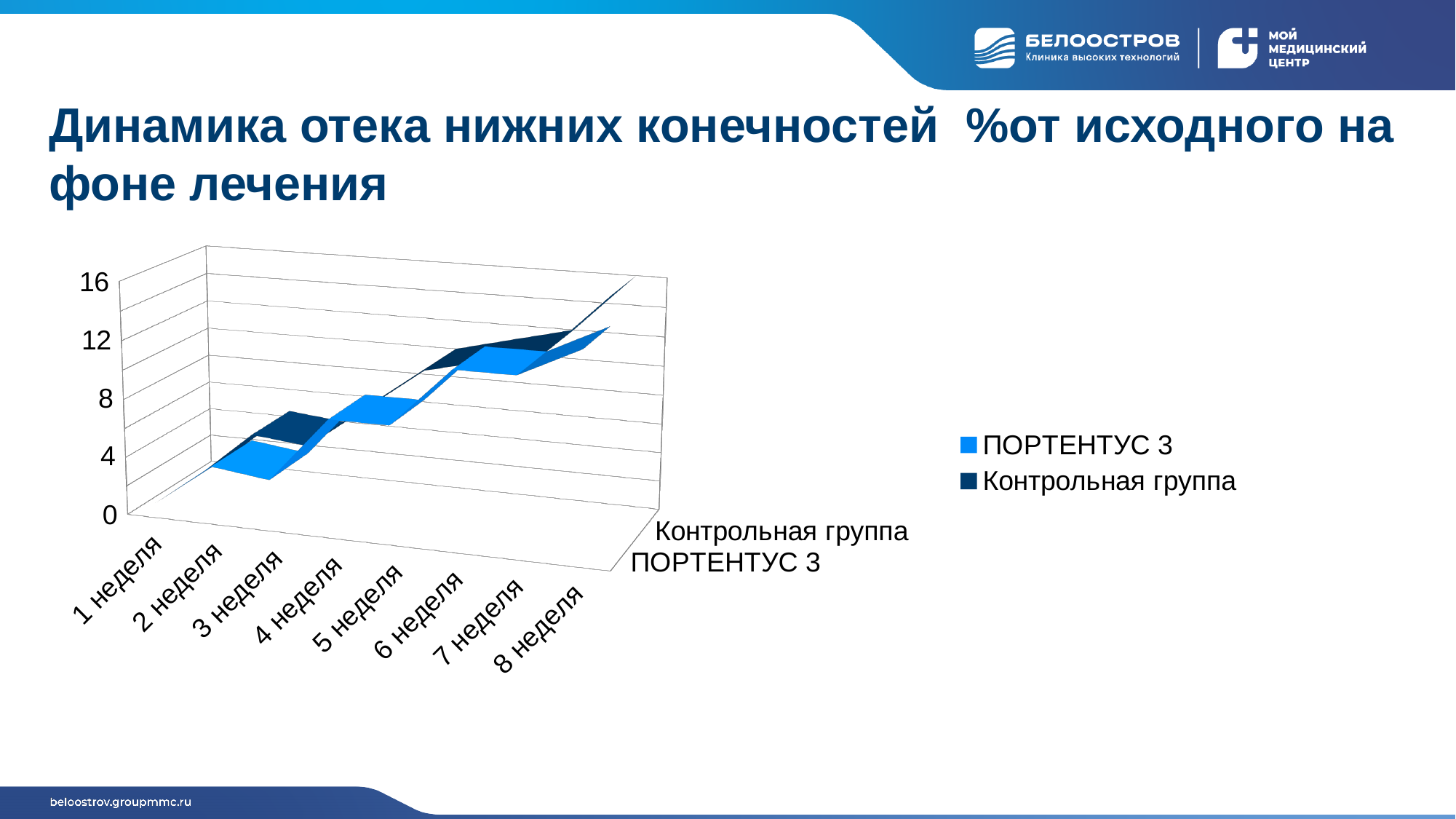
Is the value for ПОРТЕНТУС 3 at 8 неделя greater or less than 4? greater Is the value for ПОРТЕНТУС 3 at 1 неделя greater or less than 8? less Is the value for Контрольная группа at 8 неделя greater or less than 8? greater How many series does the legend list? 2 What kind of chart is shown on the slide? 3D line chart Do the values rise or fall from 1 неделя to 8 неделя? rise What is the highest tick value shown on the vertical axis? 16 Which two series are listed in the legend? ПОРТЕНТУС 3 and Контрольная группа How many week categories are shown along the x axis? 8